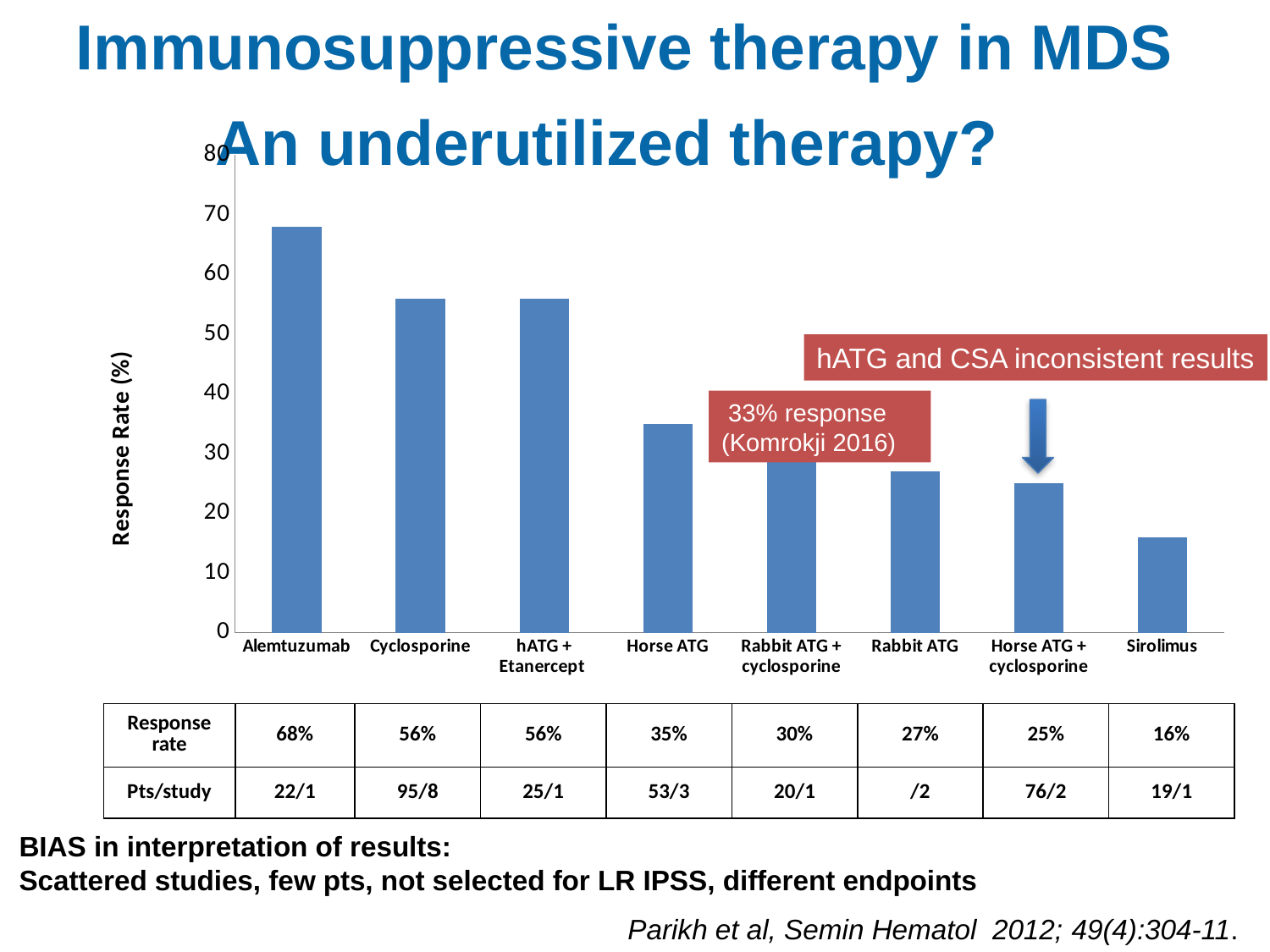
Which has a higher response rate, Horse ATG or Rabbit ATG? Horse ATG Is the response rate for Horse ATG + cyclosporine greater or less than 30? less Which therapy has the highest response rate? Alemtuzumab How many therapies are plotted on the chart? 8 What is the response rate for Sirolimus? 16% Do the response rates rise or fall from left to right across the chart? fall What kind of chart is shown on the slide? bar chart Which therapy has the lowest response rate? Sirolimus What is the response rate for Horse ATG? 35% What is the difference in response rate between Alemtuzumab and Cyclosporine? 12% What is the response rate for Alemtuzumab? 68% What is the label on the vertical axis of the chart? Response Rate (%)